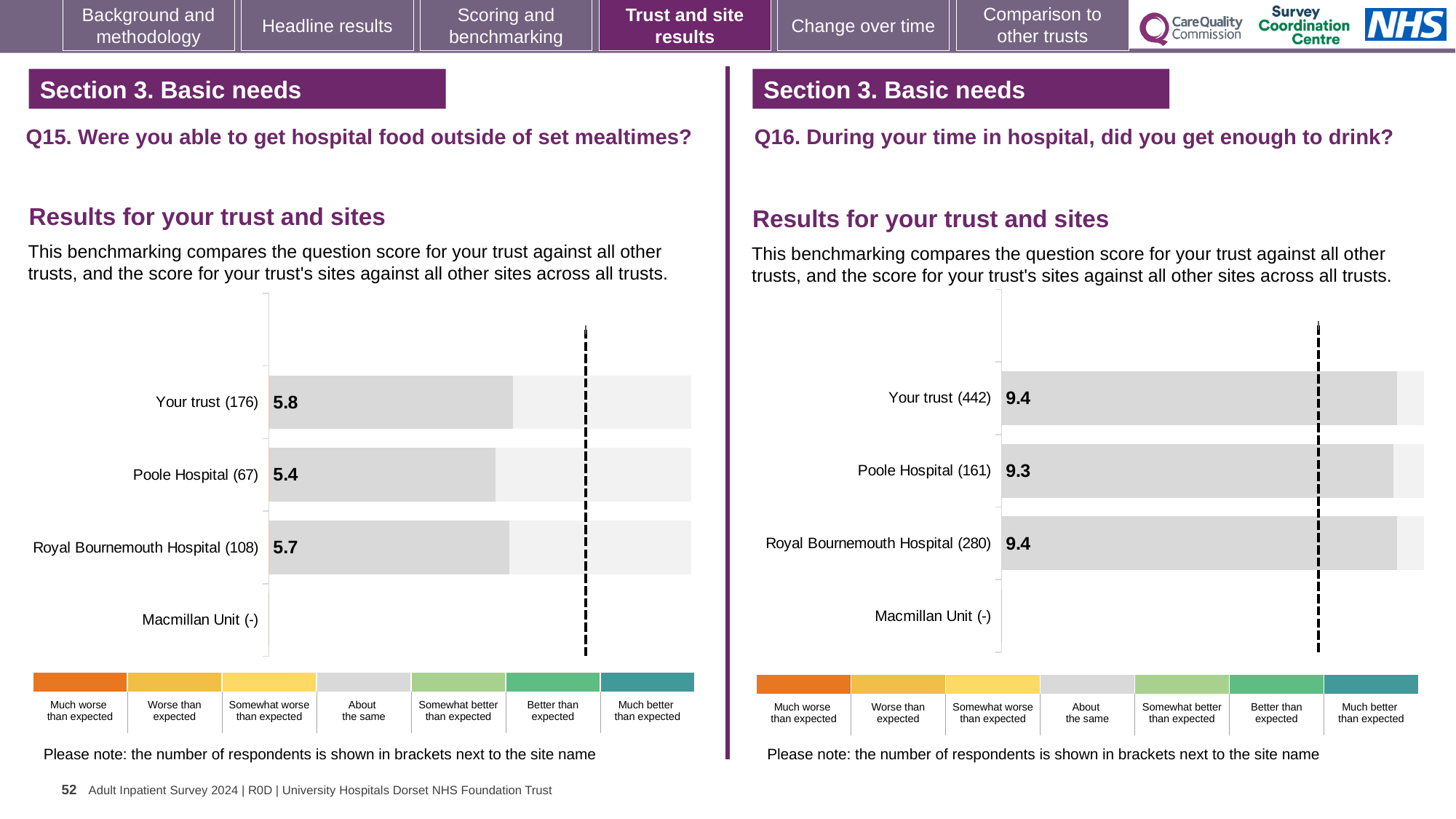
In the Q16 chart (right), how many site rows are listed, including Your trust? 4 In the Q15 chart (left), what is the difference between the scores for Your trust and Poole Hospital? 0.4 In the Q16 chart (right), what is the score for Your trust? 9.4 In the Q15 chart (left), which site has the lowest score? Poole Hospital In the Q16 chart (right), what is the score for Poole Hospital? 9.3 In the Q15 chart (left), what is the score for Royal Bournemouth Hospital? 5.7 In the Q15 chart (left), how many respondents are shown in brackets for Royal Bournemouth Hospital? 108 In the Q16 chart (right), what is the score for Royal Bournemouth Hospital? 9.4 In the Q15 chart (left), what is the score for Your trust? 5.8 In the Q15 chart (left), what is the score for Poole Hospital? 5.4 What kind of chart is used for the Q16 results (right)? Bar chart In the Q16 chart (right), what is the difference between the scores for Royal Bournemouth Hospital and Poole Hospital? 0.1